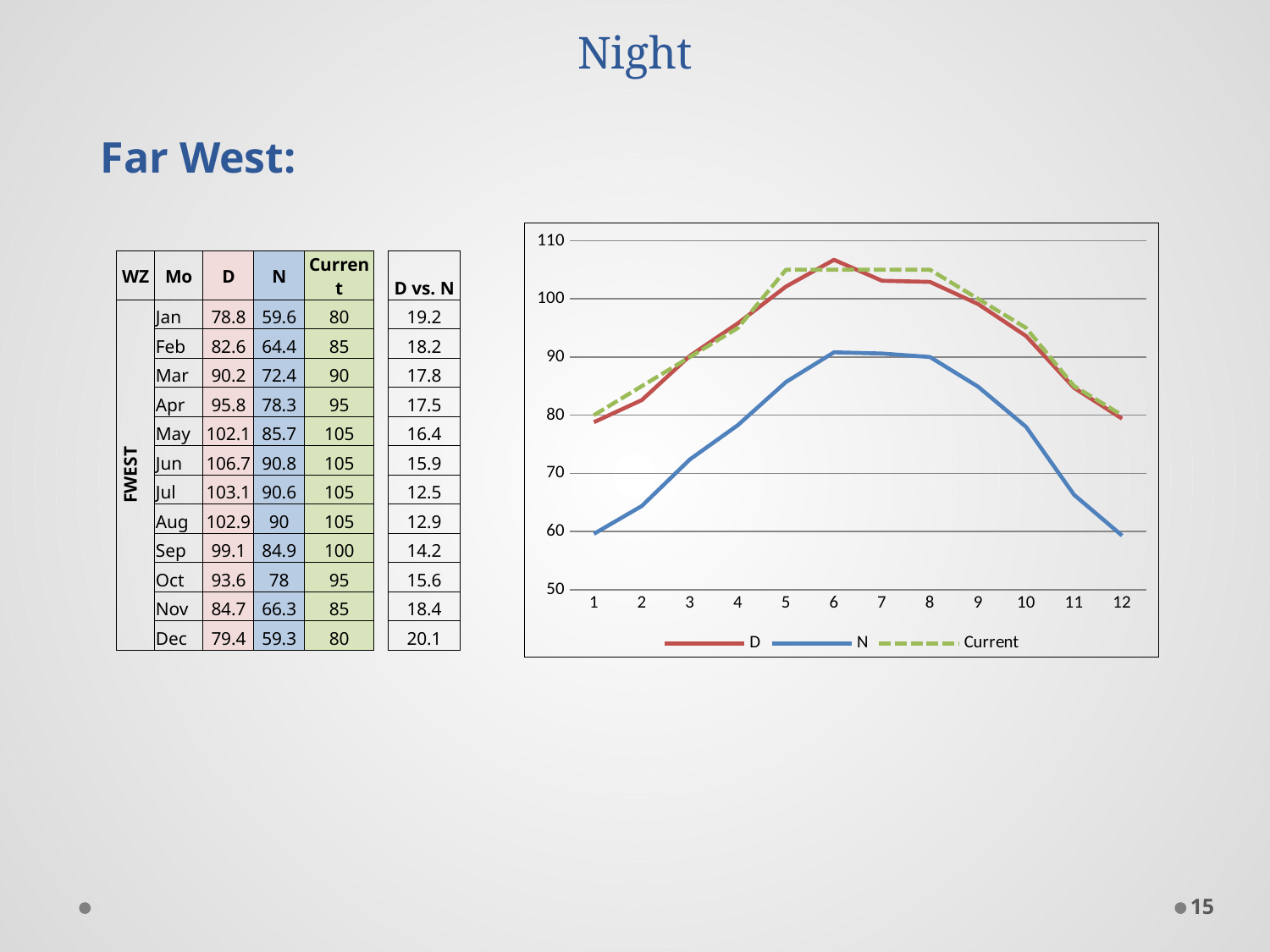
Is the value of the D series at point 6 greater or less than 100? greater Which series is drawn with a dashed line in the chart? Current Which series is lowest across all points in the chart? N At point 6, which series is higher in the chart, D or N? D What kind of chart is shown on the slide? line chart Is the value of the N series at point 6 greater or less than 100? less What are the names of the series in the chart legend? D, N, Current How many points are plotted along the x axis of the chart? 12 According to the table, what is the D value for Jun? 106.7 According to the table, what is the N value for Dec? 59.3 Is the value of the N series at point 12 greater or less than 70? less How many series does the chart legend list? 3